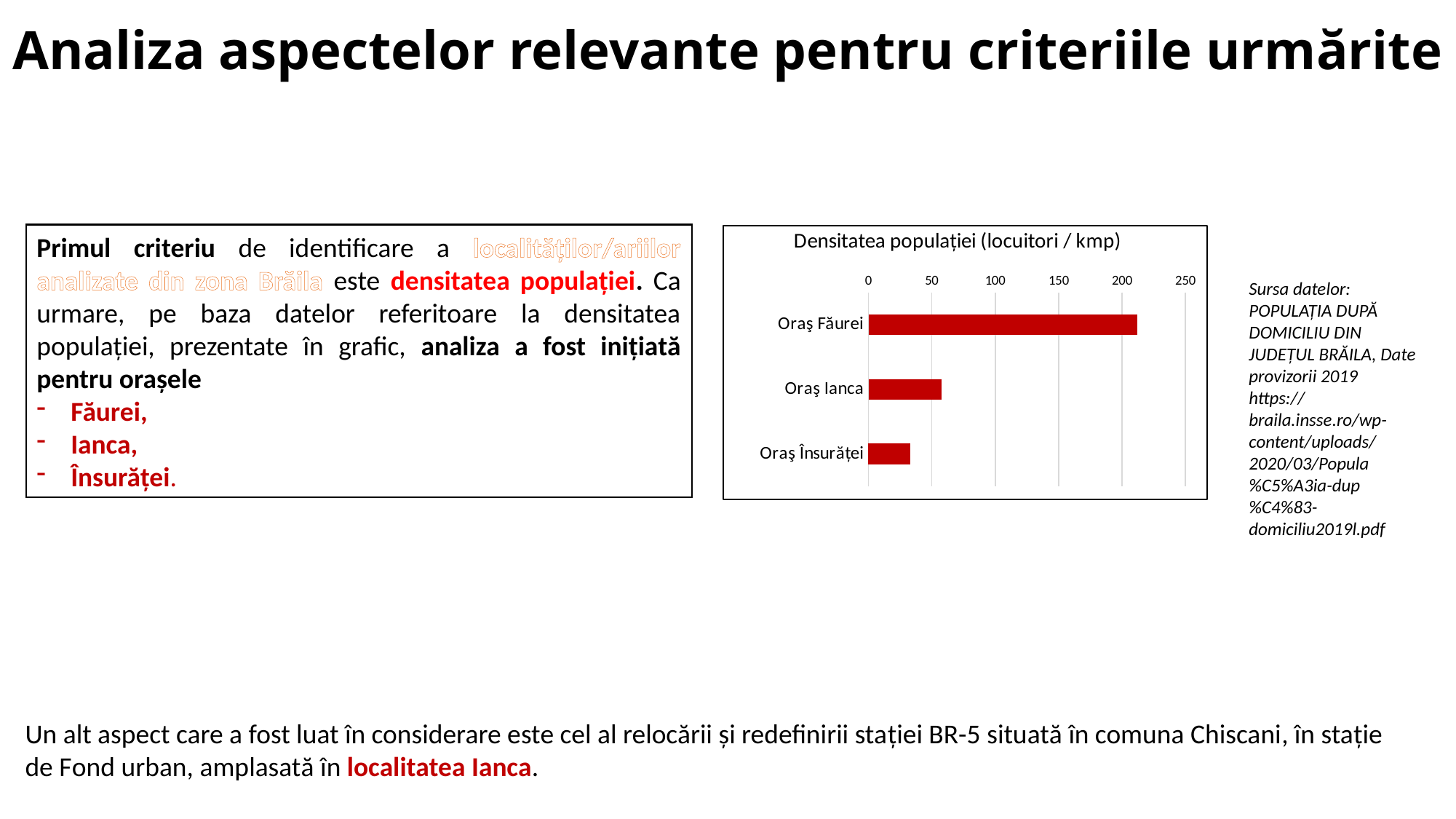
What kind of chart is shown on the slide? bar chart What is the highest value shown on the chart's value axis? 250 Is the value for Oraş Ianca greater or less than 50? greater How many towns (categories) are shown in the chart? 3 Which has a higher population density, Oraş Ianca or Oraş Însurăței? Oraş Ianca Is the value for Oraş Însurăței greater or less than 50? less What is the title of the chart? Densitatea populației (locuitori / kmp) Is the value for Oraş Ianca greater or less than 100? less Which town has the highest population density in the chart? Oraş Făurei Which town has the lowest population density in the chart? Oraş Însurăței Which has a higher population density, Oraş Făurei or Oraş Ianca? Oraş Făurei